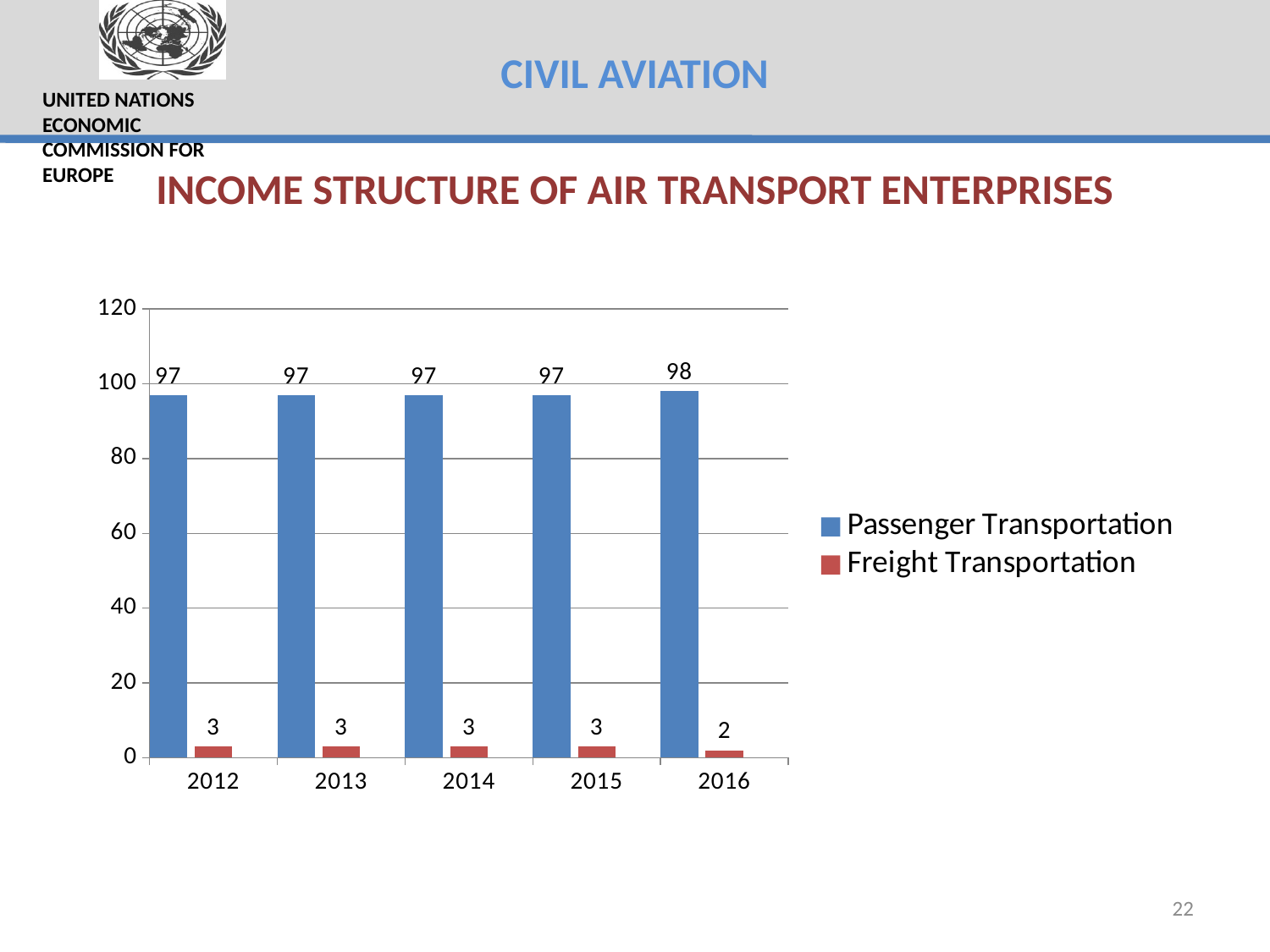
In which year is the Freight Transportation value lowest? 2016 What is the value for Freight Transportation in 2014? 3 How many series does the legend list? 2 What is the value for Passenger Transportation in 2016? 98 What is the value for Freight Transportation in 2016? 2 In which year is the Passenger Transportation value highest? 2016 Is the value for Passenger Transportation in 2013 greater or less than 80? greater What kind of chart is shown on the slide? bar chart What is the title of the chart? INCOME STRUCTURE OF AIR TRANSPORT ENTERPRISES Which is larger in 2015, Passenger Transportation or Freight Transportation? Passenger Transportation What is the difference between Passenger Transportation and Freight Transportation in 2012? 94 How many years are shown on the x axis? 5